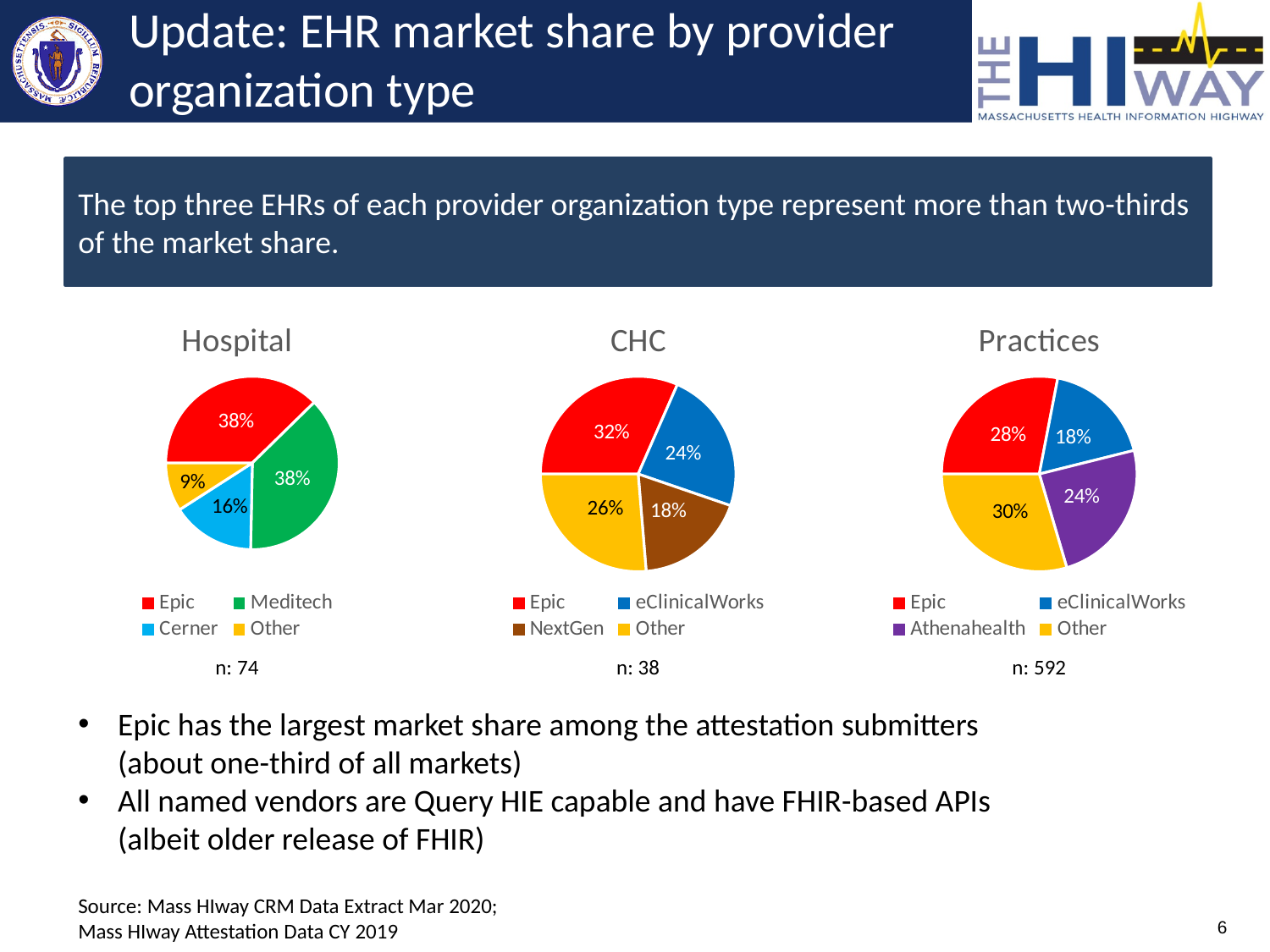
In the Hospital pie chart, what share does Cerner have? 16% What is the n value shown under the Practices pie chart? n: 592 In the CHC pie chart, which slice is the smallest? NextGen What type of chart is used for the CHC data? Pie chart In the Practices pie chart, which slice is the largest? Other In the Hospital pie chart, what share does Other have? 9% In the CHC pie chart, what share does eClinicalWorks have? 24% How many slices does the Hospital pie chart have? 4 In the Practices pie chart, what is the difference between the Other share and the eClinicalWorks share? 12% In the Practices pie chart, what share does Athenahealth have? 24% In the Practices pie chart, which is larger, Epic or eClinicalWorks? Epic In the CHC pie chart, which vendor has the largest share? Epic